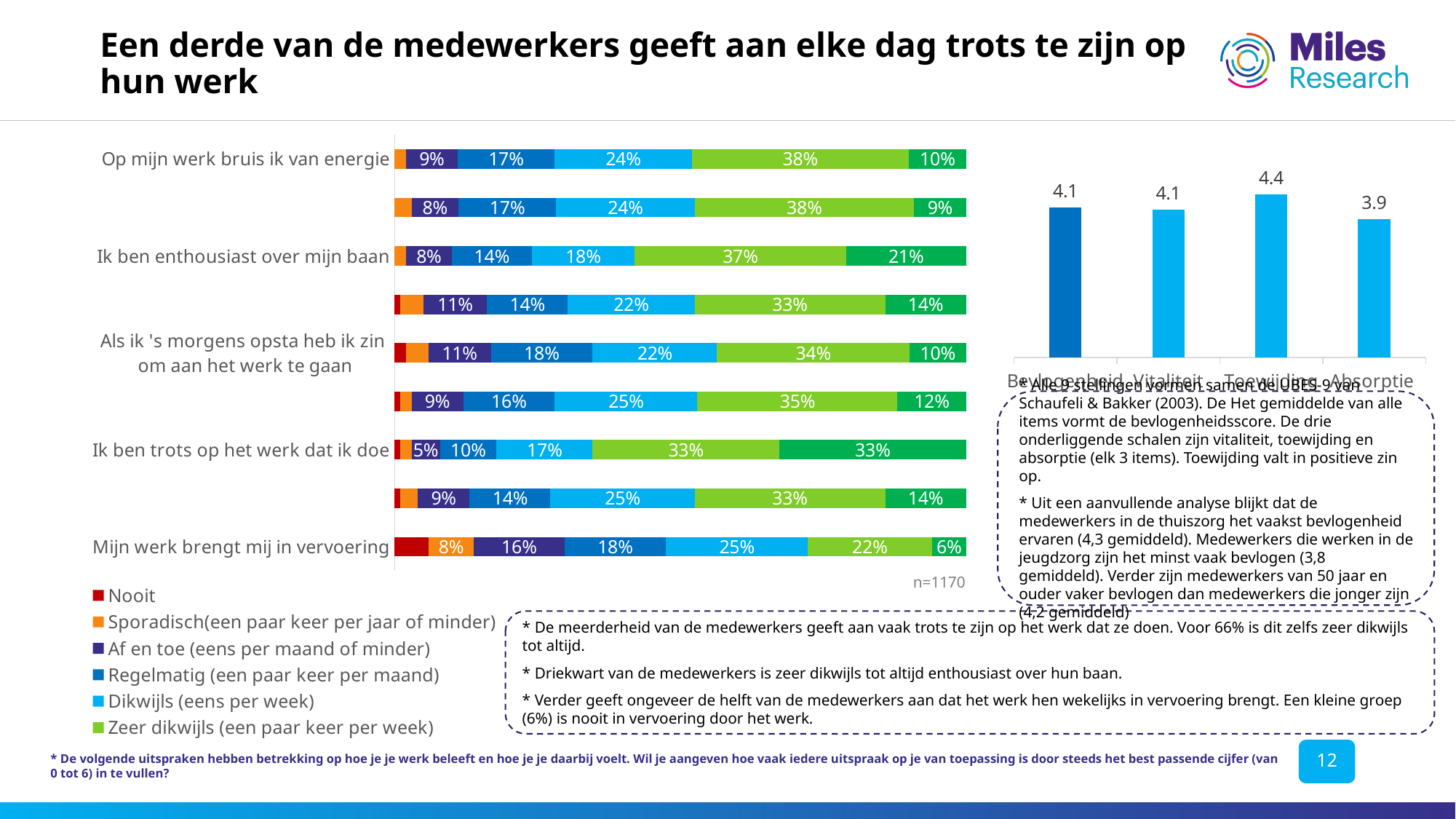
How many series does the legend of the chart on the left list? 6 In the bar chart on the right, which category has the highest value? Toewijding How many categories are shown in the bar chart on the right? 4 In the stacked bar chart on the left, what percentage is shown for 'Dikwijls (eens per week)' for 'Op mijn werk bruis ik van energie'? 24% In the bar chart on the right, which category has the lowest value? Absorptie In the stacked bar chart on the left, what percentage is shown for 'Zeer dikwijls (een paar keer per week)' for 'Ik ben trots op het werk dat ik doe'? 33% In the stacked bar chart on the left, which statement has the larger 'Zeer dikwijls' share: 'Ik ben enthousiast over mijn baan' or 'Mijn werk brengt mij in vervoering'? Ik ben enthousiast over mijn baan In the bar chart on the right, what is the difference between the values for Toewijding and Absorptie? 0.5 In the bar chart on the right, what is the value for Toewijding? 4.4 What kind of chart is the chart on the left? Stacked bar chart In the stacked bar chart on the left, what percentage is shown for 'Dikwijls (eens per week)' for 'Mijn werk brengt mij in vervoering'? 25% In the stacked bar chart on the left, what is the difference between the 'Regelmatig (een paar keer per maand)' percentages for 'Als ik 's morgens opsta heb ik zin om aan het werk te gaan' and 'Ik ben trots op het werk dat ik doe'? 8 percentage points